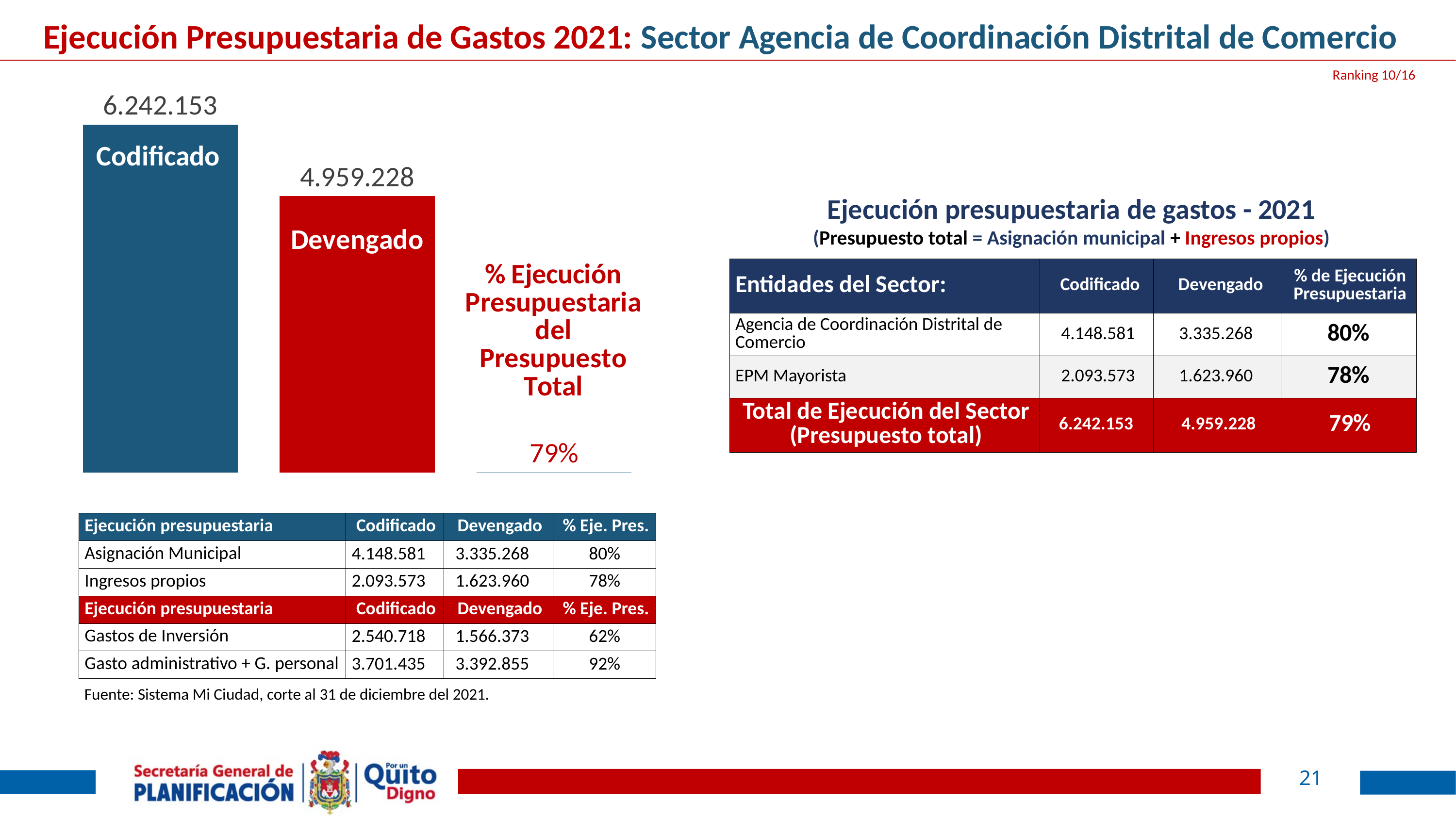
What colour is the Codificado bar in the chart? Blue What is the difference between the Codificado and Devengado bars in the chart? 1.282.925 Which bar in the chart is the highest? Codificado What is the value of the Codificado bar in the bar chart? 6.242.153 What percentage is shown next to the bar chart as the % Ejecución Presupuestaria del Presupuesto Total? 79% Which is larger in the bar chart, Codificado or Devengado? Codificado What is the value of the Devengado bar in the bar chart? 4.959.228 What colour is the Devengado bar in the chart? Red What kind of chart is shown on the left of the slide? Bar chart Which bar in the chart is the lowest? Devengado How many bars are shown in the bar chart? 2